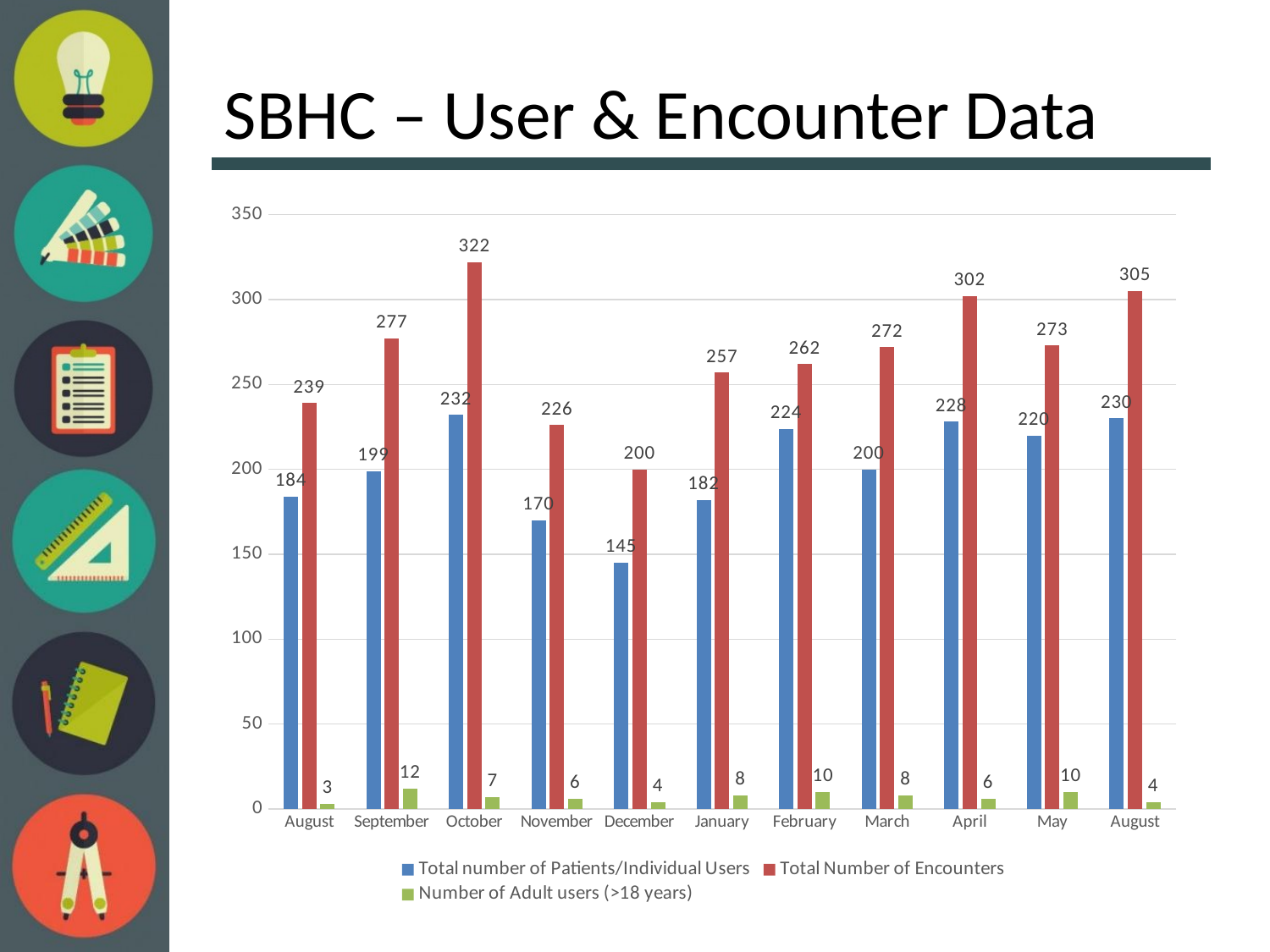
Which month has the highest Total Number of Encounters? October Is the Total number of Patients/Individual Users for November greater or less than 200? less What is the title of the slide containing the chart? SBHC – User & Encounter Data What is the Total number of Patients/Individual Users for December? 145 What is the Total Number of Encounters for October? 322 Which month has the lowest Total number of Patients/Individual Users? December How many series does the legend list? 3 What kind of chart is shown on the slide? bar chart Which is larger: the Total Number of Encounters in March or in May? May What is the Number of Adult users (>18 years) for September? 12 What is the difference between the Total Number of Encounters and the Total number of Patients/Individual Users in April? 74 Which colour represents the Number of Adult users (>18 years) series? green